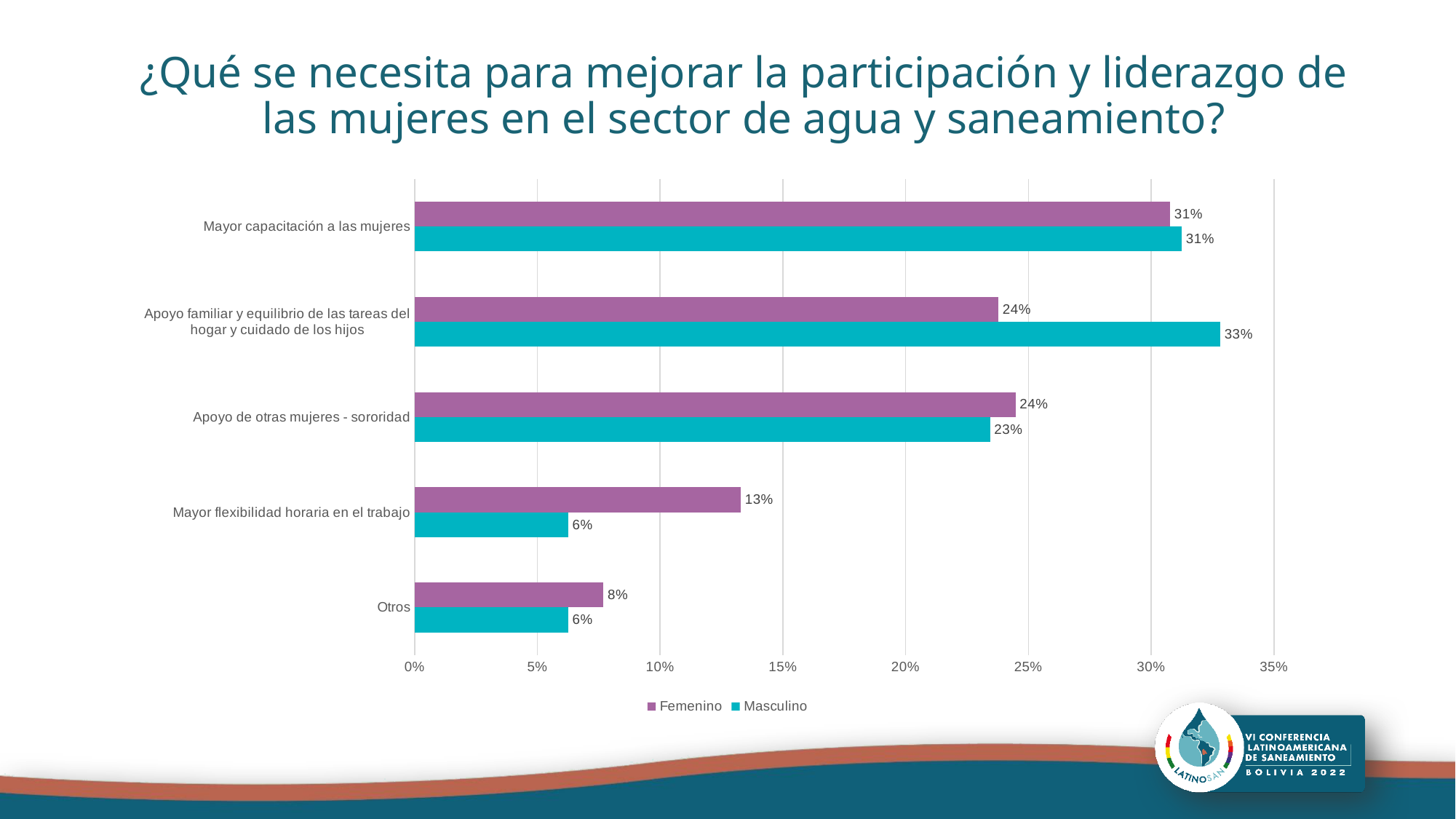
Which category has the highest Masculino value? Apoyo familiar y equilibrio de las tareas del hogar y cuidado de los hijos What is the Masculino value for "Otros"? 6% Is the Masculino value for "Apoyo familiar y equilibrio de las tareas del hogar y cuidado de los hijos" greater or less than 30%? greater How many categories are shown on the chart? 5 What kind of chart is shown on the slide? Bar chart Which category has the lowest Femenino value? Otros How many series does the legend list? 2 What is the Masculino value for "Apoyo familiar y equilibrio de las tareas del hogar y cuidado de los hijos"? 33% For "Apoyo familiar y equilibrio de las tareas del hogar y cuidado de los hijos", which series has the larger value, Femenino or Masculino? Masculino What is the Femenino value for "Mayor flexibilidad horaria en el trabajo"? 13% Is the Femenino value for "Otros" greater or less than 10%? less What is the difference between the Femenino and Masculino values for "Mayor flexibilidad horaria en el trabajo"? 7 percentage points